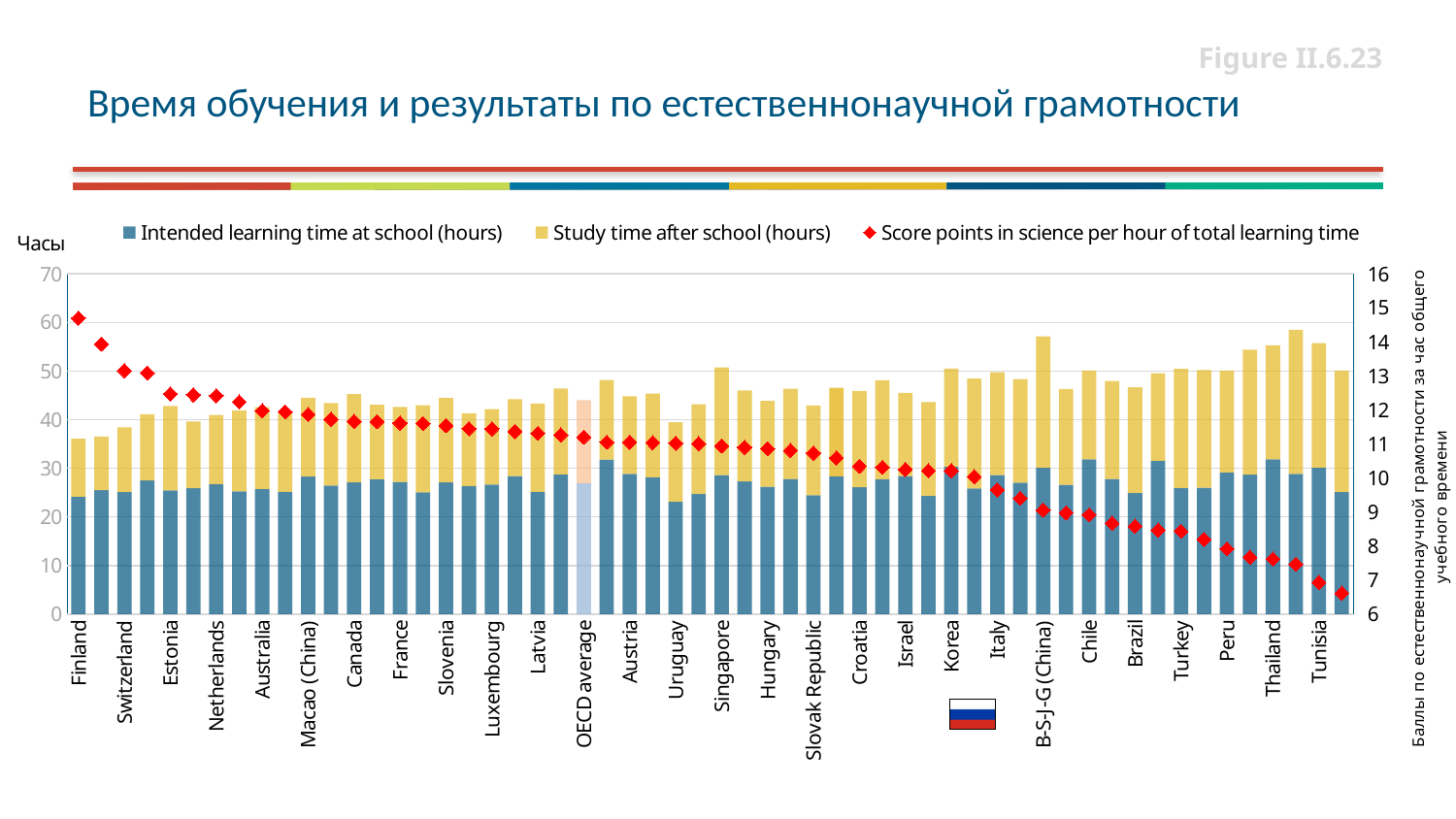
Is the total learning time (school plus after school) for Thailand greater or less than 50 hours? greater Is the value of score points in science per hour of total learning time for Finland greater or less than 14? greater Which has the larger score points in science per hour of total learning time, Finland or Tunisia? Finland How many series does the legend list? 3 Which series is shown with red diamond markers? Score points in science per hour of total learning time Do the score points in science per hour of total learning time rise or fall from left to right along the x axis? Fall Is the total learning time (school plus after school) for Finland greater or less than 40 hours? less What kind of chart is shown on the slide? A combined stacked bar and line (marker) chart Which country has the highest score points in science per hour of total learning time? Finland What is the title of the chart? Время обучения и результаты по естественнонаучной грамотности Which has the larger total learning time (school plus after school), Finland or Thailand? Thailand